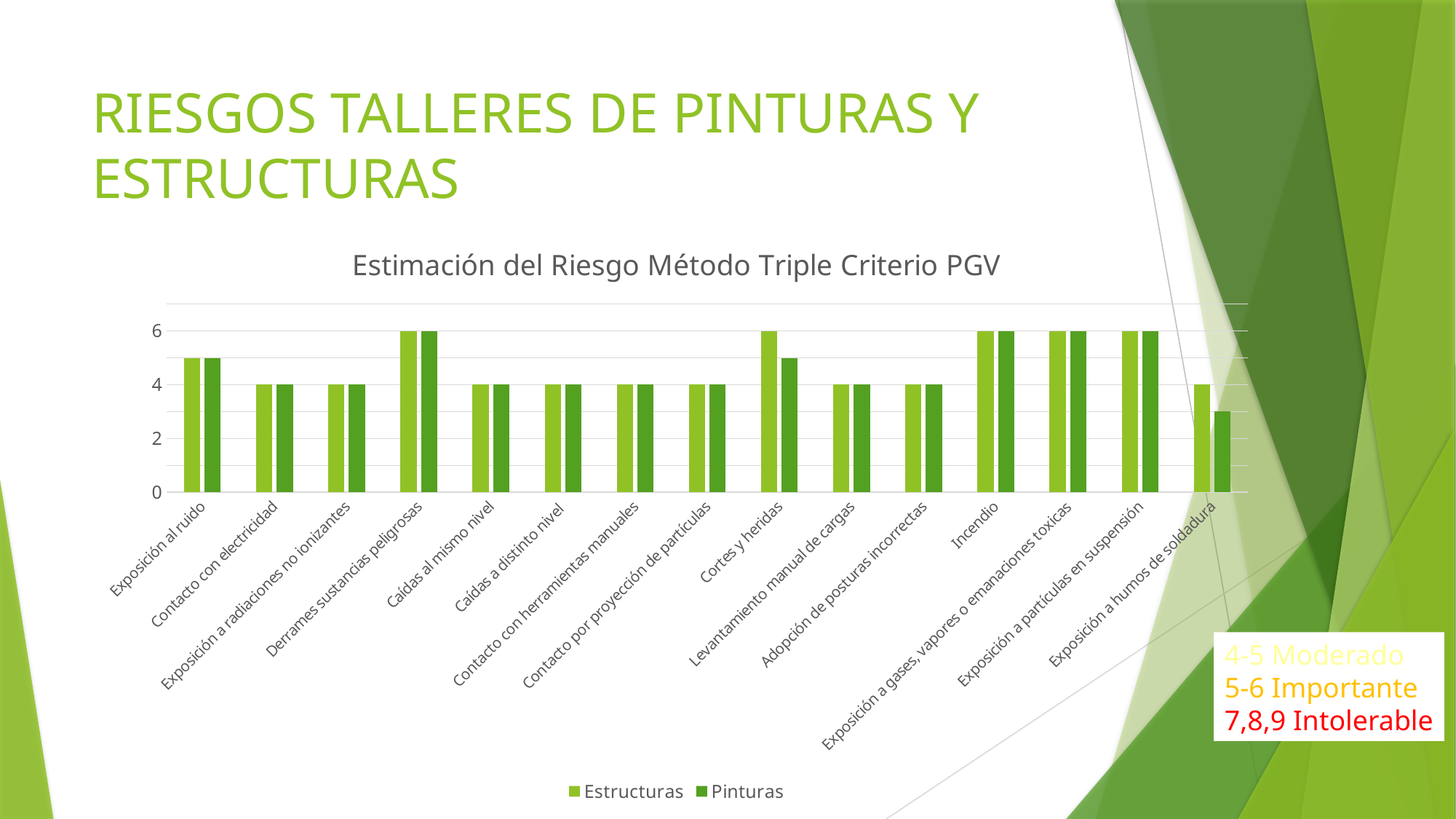
Is the Pinturas value for Exposición a humos de soldadura greater or less than 4? less How many risk categories are shown on the x axis? 15 How many series does the legend list? 2 What is the title of the chart? Estimación del Riesgo Método Triple Criterio PGV What kind of chart is shown on the slide? bar chart What is the difference between the Estructuras value for Incendio and the Pinturas value for Caídas al mismo nivel? 2 For Cortes y heridas, which series has the larger value, Estructuras or Pinturas? Estructuras What is the Estructuras value for Exposición a humos de soldadura? 4 What is the Estructuras value for Derrames sustancias peligrosas? 6 What is the Estructuras value for Incendio? 6 Is the Estructuras value for Exposición al ruido greater or less than 4? greater What is the Pinturas value for Contacto con electricidad? 4